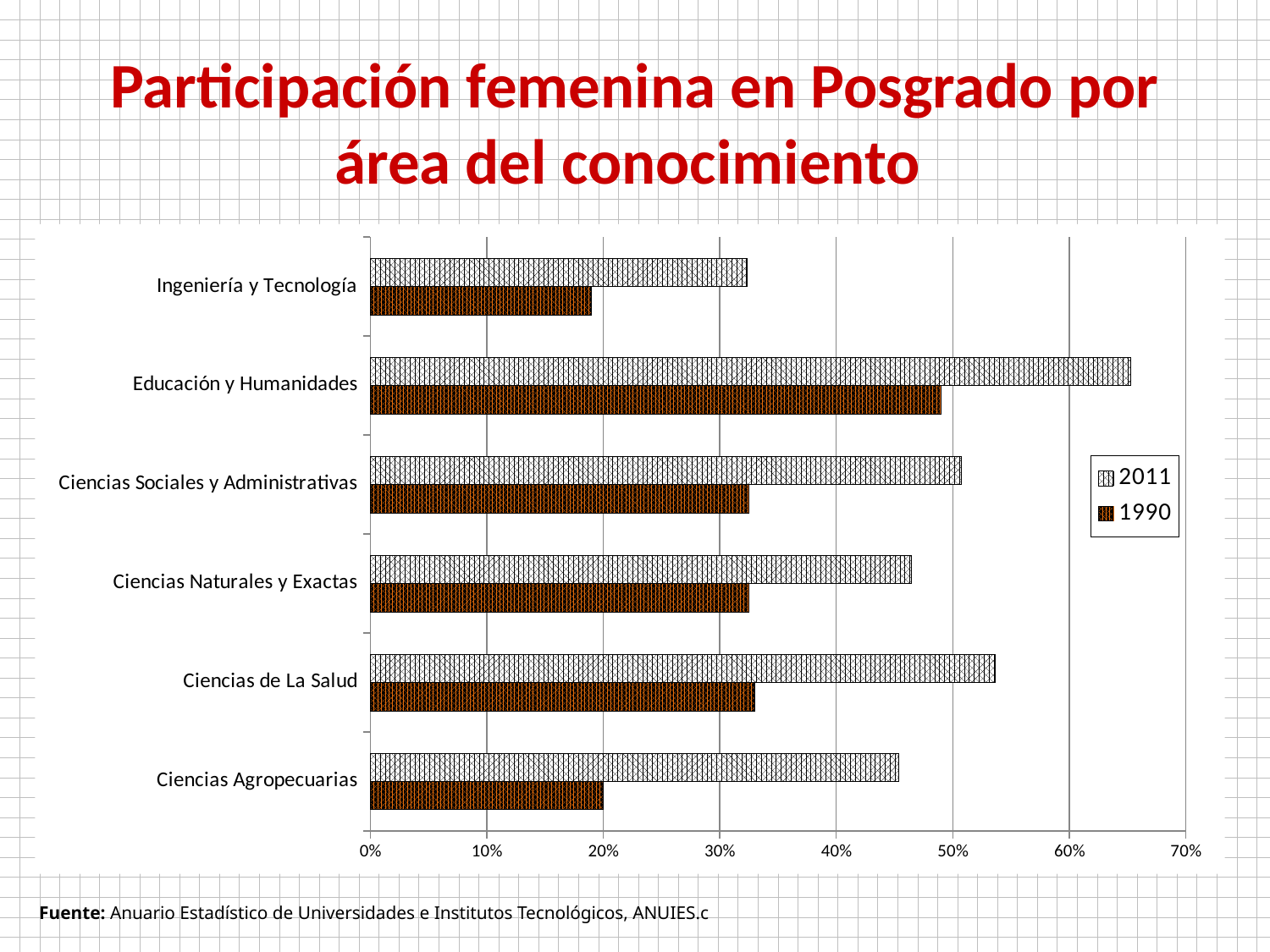
How many areas of knowledge (categories) are shown on the chart? 6 Which is larger for 2011: Ciencias de La Salud or Ciencias Naturales y Exactas? Ciencias de La Salud How many series does the legend list? 2 Is the 2011 value for Ciencias de La Salud greater or less than 50%? greater What are the two years listed in the chart legend? 2011 and 1990 Is the 2011 value for Educación y Humanidades greater or less than 60%? greater Which area has the highest value for 1990? Educación y Humanidades Which area has the highest value for 2011? Educación y Humanidades What kind of chart is shown on the slide? bar chart Which area has the lowest value for 2011? Ingeniería y Tecnología Which is larger for 1990: Educación y Humanidades or Ciencias Sociales y Administrativas? Educación y Humanidades